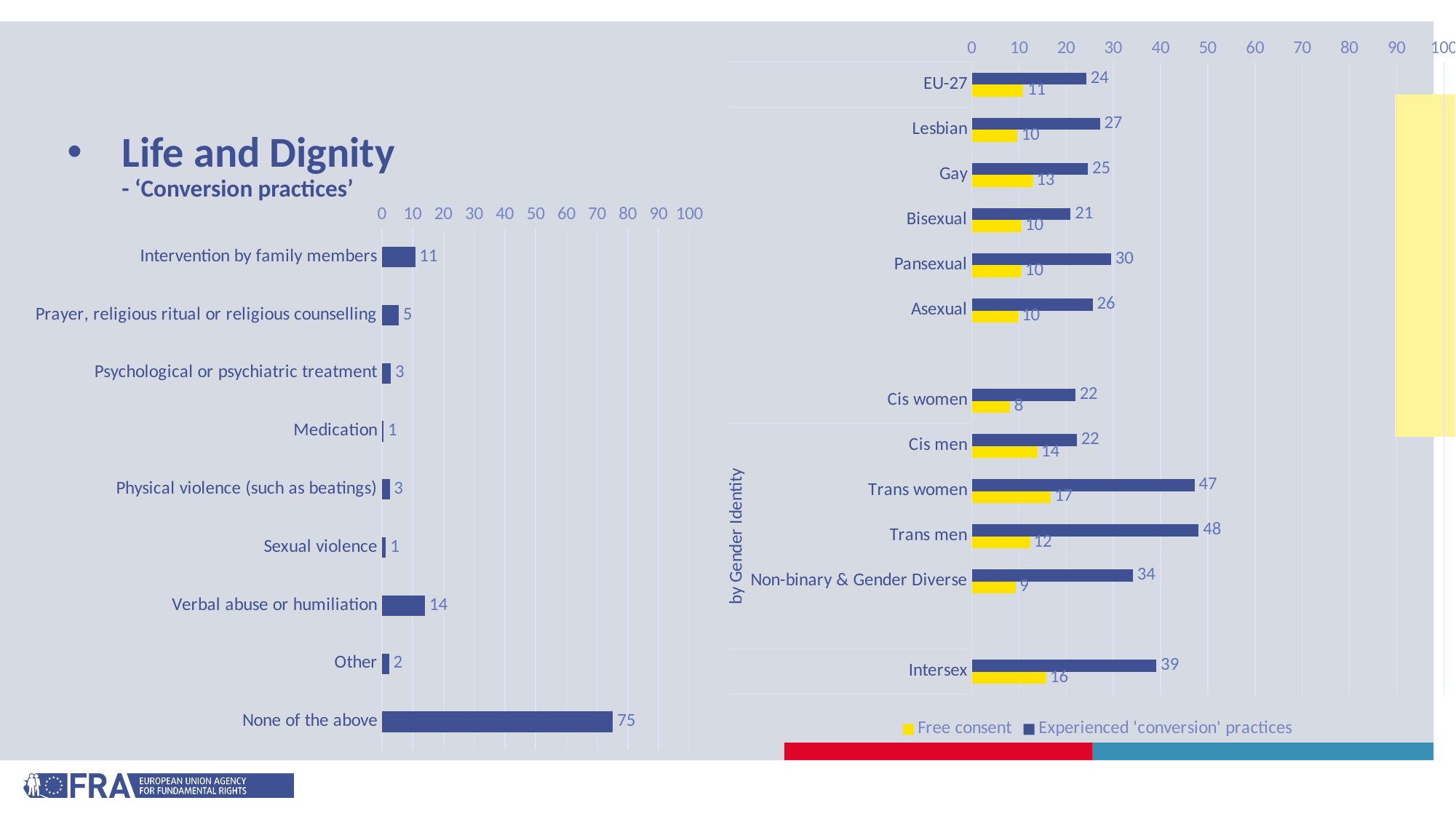
In the right chart, which group has the lowest Free consent value? Cis women In the left chart, what is the value for Verbal abuse or humiliation? 14 What kind of chart is the left chart? Bar chart In the right chart, which is larger: the Experienced 'conversion' practices value for Intersex or for Non-binary & Gender Diverse? Intersex In the right chart, what is the difference between the Experienced 'conversion' practices value and the Free consent value for EU-27? 13 In the left chart, how many categories are shown? 9 In the right chart, which group has the highest Experienced 'conversion' practices value? Trans men In the left chart, what is the difference between Intervention by family members and Prayer, religious ritual or religious counselling? 6 In the right chart, what is the Experienced 'conversion' practices value for Trans women? 47 How many series does the legend of the right chart list? 2 In the left chart, which category has the highest value? None of the above In the right chart, what is the Free consent value for Cis men? 14